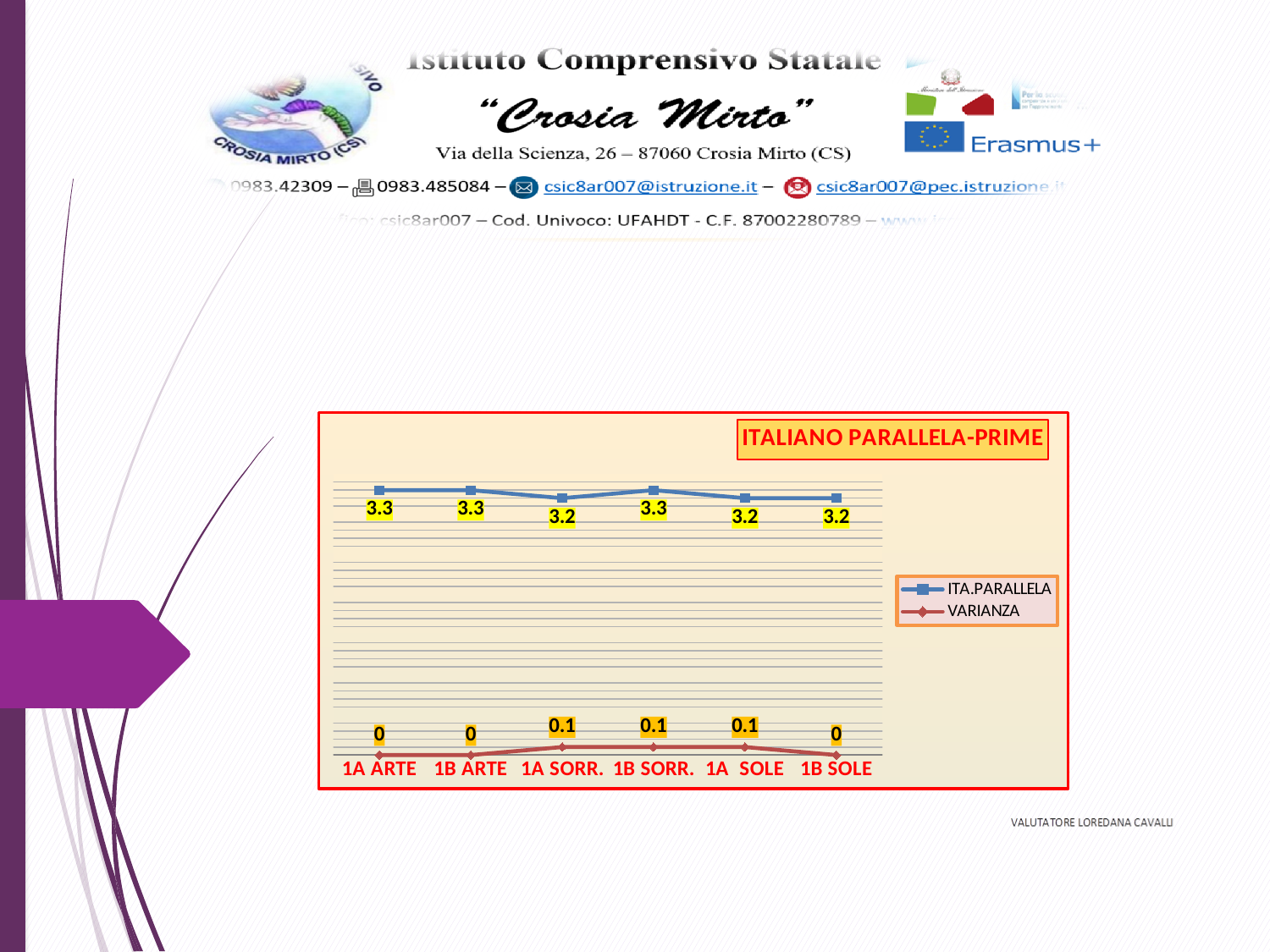
What is the ITA.PARALLELA value for 1A ARTE? 3.3 What is the title of the chart? ITALIANO PARALLELA-PRIME What is the VARIANZA value for 1B SORR.? 0.1 Which has the larger ITA.PARALLELA value, 1B ARTE or 1A SORR.? 1B ARTE How many series does the legend list? 2 How many categories are shown on the x axis? 6 What is the VARIANZA value for 1B SOLE? 0 Which has the larger VARIANZA value, 1A SORR. or 1A ARTE? 1A SORR. What is the ITA.PARALLELA value for 1A SOLE? 3.2 What type of chart is shown on the slide? line chart Which series is drawn in blue in the legend? ITA.PARALLELA What is the difference between the ITA.PARALLELA values for 1B SORR. and 1B SOLE? 0.1